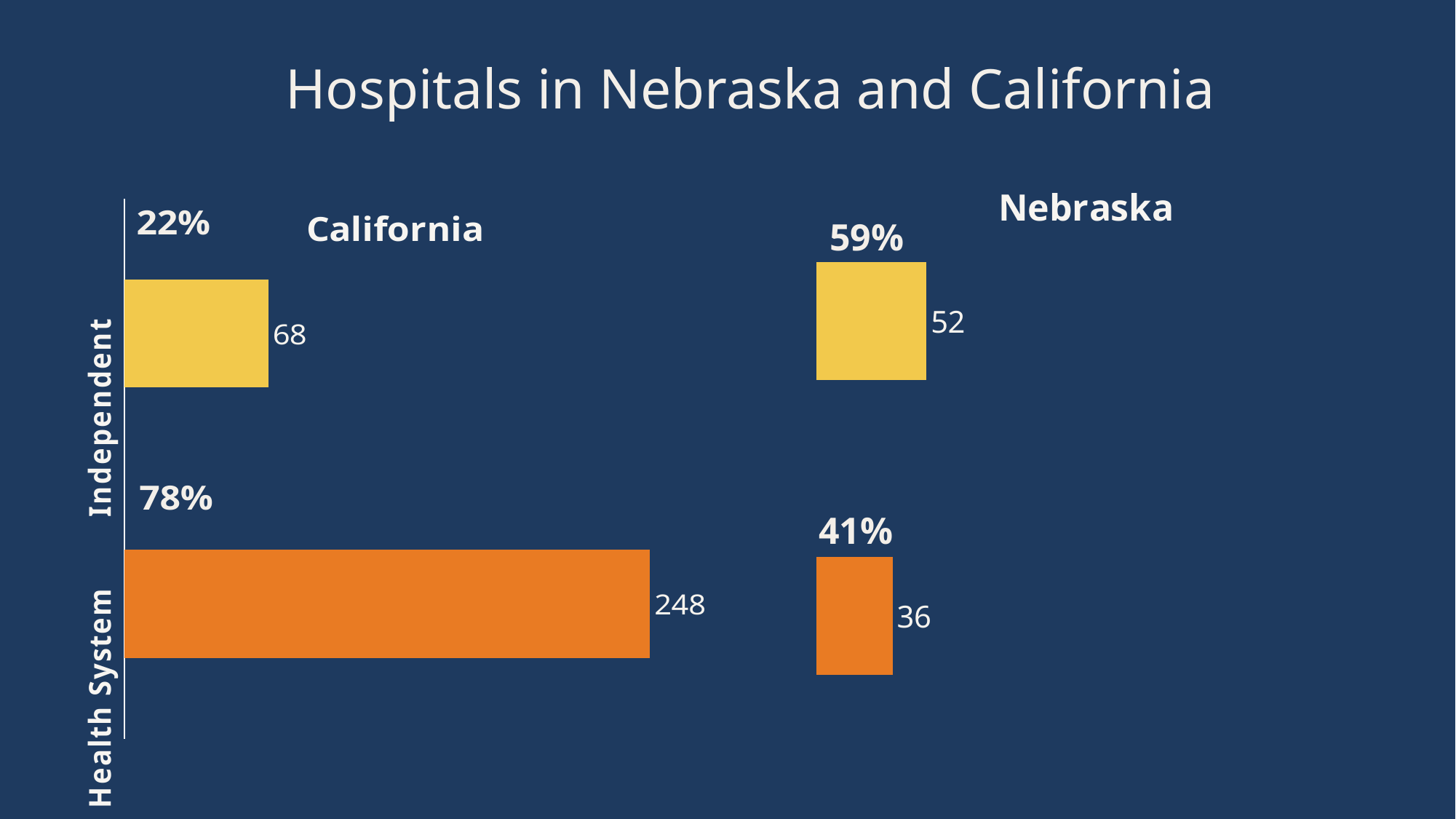
What is the difference between the number of Health System hospitals and Independent hospitals in California? 180 What percentage of California hospitals are Health System hospitals? 78% Which bar has the highest value on the chart? California Health System Which is larger in Nebraska: the number of Independent hospitals or the number of Health System hospitals? Independent What is the number of Health System hospitals in Nebraska? 36 What is the number of Independent hospitals in Nebraska? 52 What is the number of Health System hospitals in California? 248 Which bar has the lowest value on the chart? Nebraska Health System What is the number of Independent hospitals in California? 68 What type of chart is shown on the slide? Bar chart What percentage of Nebraska hospitals are Independent? 59% What is the total number of hospitals shown for Nebraska? 88